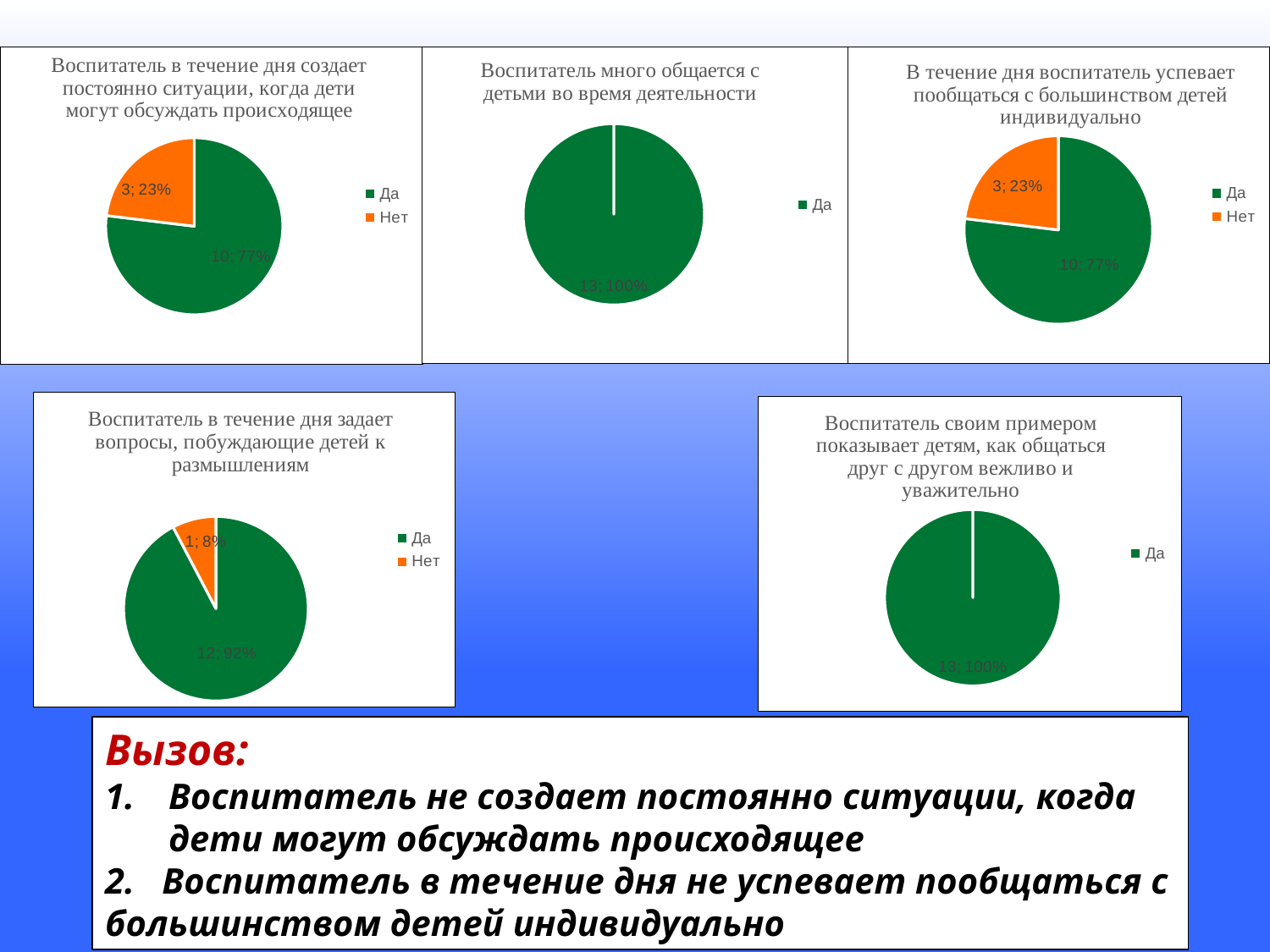
In the top-right chart 'В течение дня воспитатель успевает пообщаться с большинством детей индивидуально', how many respondents answered 'Нет'? 3 In the bottom-left chart 'Воспитатель в течение дня задает вопросы, побуждающие детей к размышлениям', what is the difference between the number of 'Да' and 'Нет' responses? 11 In the top-left chart 'Воспитатель в течение дня создает постоянно ситуации, когда дети могут обсуждать происходящее', how many respondents answered 'Да'? 10 What type of chart is used in the bottom-right chart 'Воспитатель своим примером показывает детям, как общаться друг с другом вежливо и уважительно'? Pie chart In the top-middle chart 'Воспитатель много общается с детьми во время деятельности', how many entries does the legend list? 1 In the bottom-left chart 'Воспитатель в течение дня задает вопросы, побуждающие детей к размышлениям', what share of the pie is 'Нет'? 8% In the bottom-right chart 'Воспитатель своим примером показывает детям, как общаться друг с другом вежливо и уважительно', how many respondents answered 'Да'? 13 In the top-left chart 'Воспитатель в течение дня создает постоянно ситуации, когда дети могут обсуждать происходящее', how many categories does the pie have? 2 In the top-right chart 'В течение дня воспитатель успевает пообщаться с большинством детей индивидуально', which category is the largest? Да In the top-middle chart 'Воспитатель много общается с детьми во время деятельности', what share of the pie is 'Да'? 100% In the top-left chart 'Воспитатель в течение дня создает постоянно ситуации, когда дети могут обсуждать происходящее', what share of the pie is 'Нет'? 23% In the bottom-left chart 'Воспитатель в течение дня задает вопросы, побуждающие детей к размышлениям', what colour is the 'Нет' slice? Orange